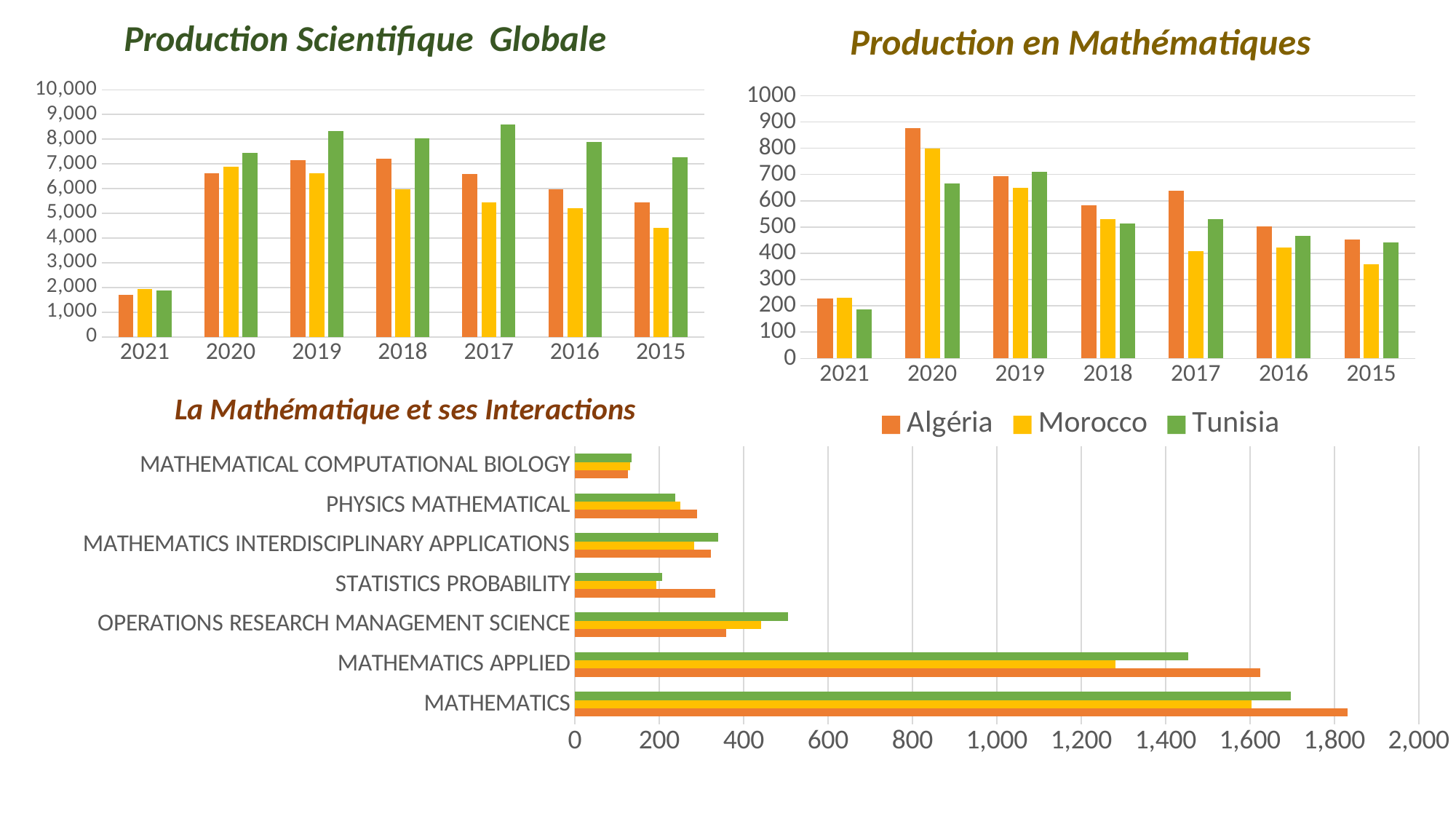
What kind of chart is 'La Mathématique et ses Interactions'? bar chart In the 'Production en Mathématiques' chart, which is larger in 2020, Algéria or Tunisia? Algéria In the 'Production Scientifique Globale' chart, which year has the highest value for Tunisia? 2017 How many categories are shown in the 'La Mathématique et ses Interactions' chart? 7 What kind of chart is the 'Production Scientifique Globale' chart? bar chart In the 'Production en Mathématiques' chart, which year has the lowest value for Morocco? 2021 In the 'Production Scientifique Globale' chart, is the value for Tunisia in 2017 greater or less than 8,000? greater In the 'Production en Mathématiques' chart, is the value for Algéria in 2020 greater or less than 800? greater How many years are shown on the x axis of the 'Production Scientifique Globale' chart? 7 In the 'La Mathématique et ses Interactions' chart, which category has the highest value for Algéria? MATHEMATICS How many series does the legend on the slide list? 3 In the 'La Mathématique et ses Interactions' chart, is the value for Morocco in MATHEMATICS APPLIED greater or less than 1,400? less